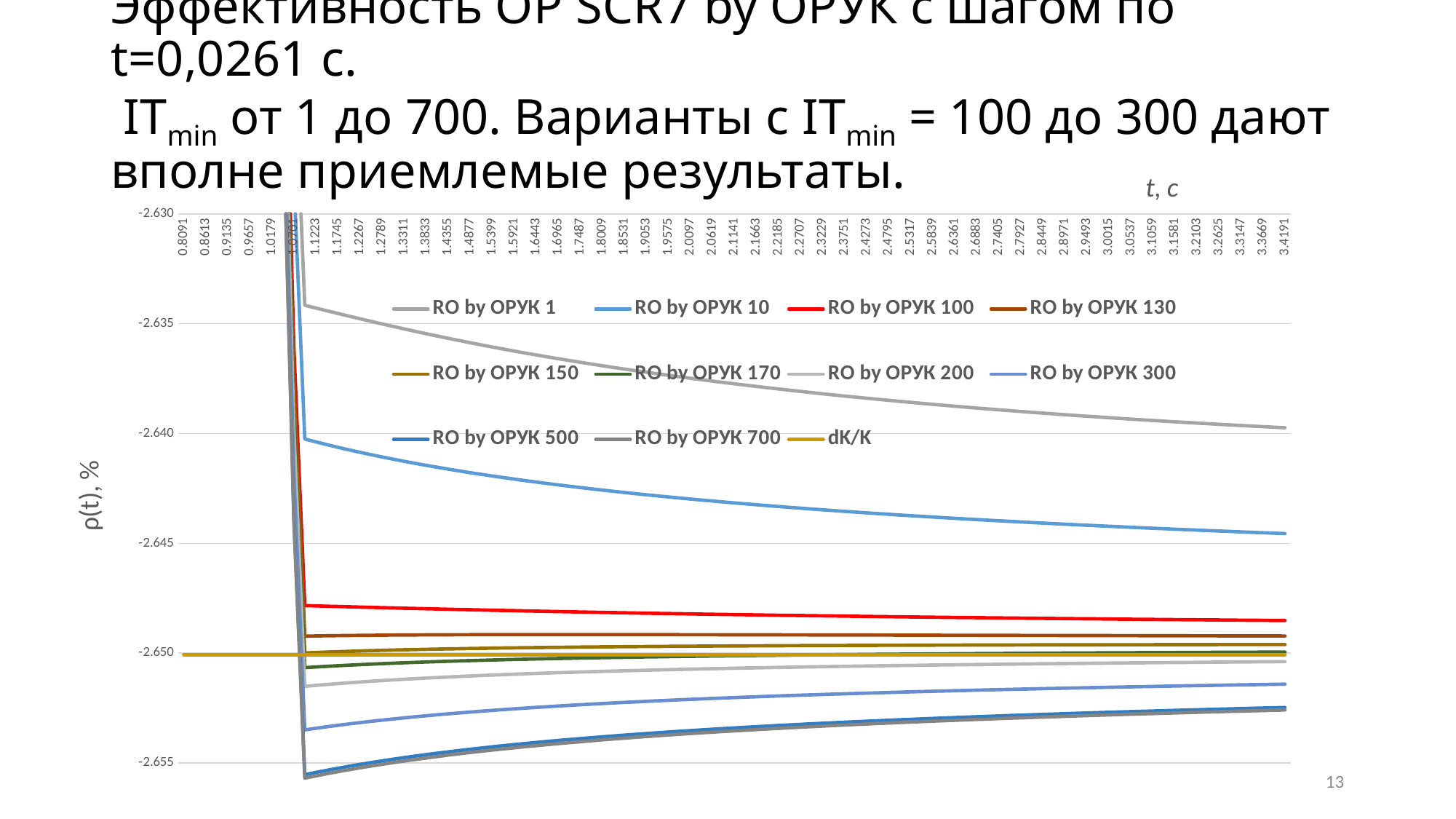
What is the label of the vertical axis of the chart? ρ(t), % Which series has the highest value at the right end of the chart (t = 3.4191)? RO by ОРУК 1 Does the dK/K line rise, fall or stay flat along the x axis? stay flat At the right end of the chart, which is larger: the value for RO by ОРУК 10 or for RO by ОРУК 300? RO by ОРУК 10 What kind of chart is shown on the slide? line chart At the right end of the chart, is the value for RO by ОРУК 500 greater or less than -2.650? less At the right end of the chart, is the value for RO by ОРУК 100 greater or less than -2.650? greater Does the RO by ОРУК 700 line rise or fall along the x axis after its initial drop? rise How many series does the chart legend list? 11 Does the RO by ОРУК 1 line rise or fall along the x axis after its initial spike? fall What is the label of the horizontal axis of the chart? t, c